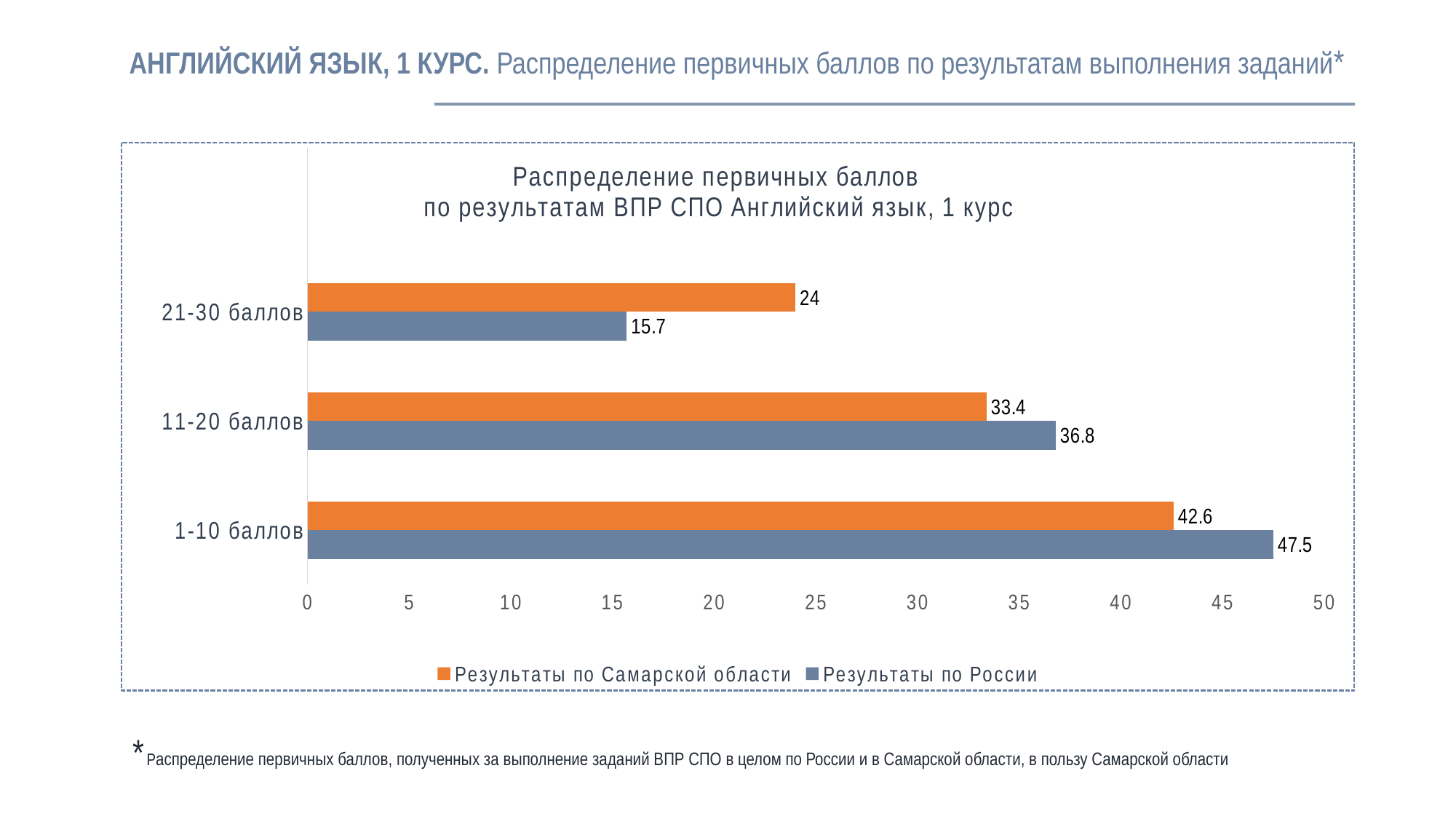
Which colour represents "Результаты по Самарской области" in the chart? Orange What is the difference between "Результаты по России" and "Результаты по Самарской области" in the "1-10 баллов" category? 4.9 What is the difference between "Результаты по Самарской области" and "Результаты по России" in the "21-30 баллов" category? 8.3 Which category has the lowest value for "Результаты по России"? 21-30 баллов How many score categories are shown on the chart? 3 What type of chart is shown on the slide? Bar chart What is the value for "Результаты по России" in the "1-10 баллов" category? 47.5 What is the value for "Результаты по России" in the "11-20 баллов" category? 36.8 In the "11-20 баллов" category, which series has the larger value? Результаты по России What is the value for "Результаты по Самарской области" in the "21-30 баллов" category? 24 How many series does the legend list? 2 Which category has the highest value for "Результаты по Самарской области"? 1-10 баллов